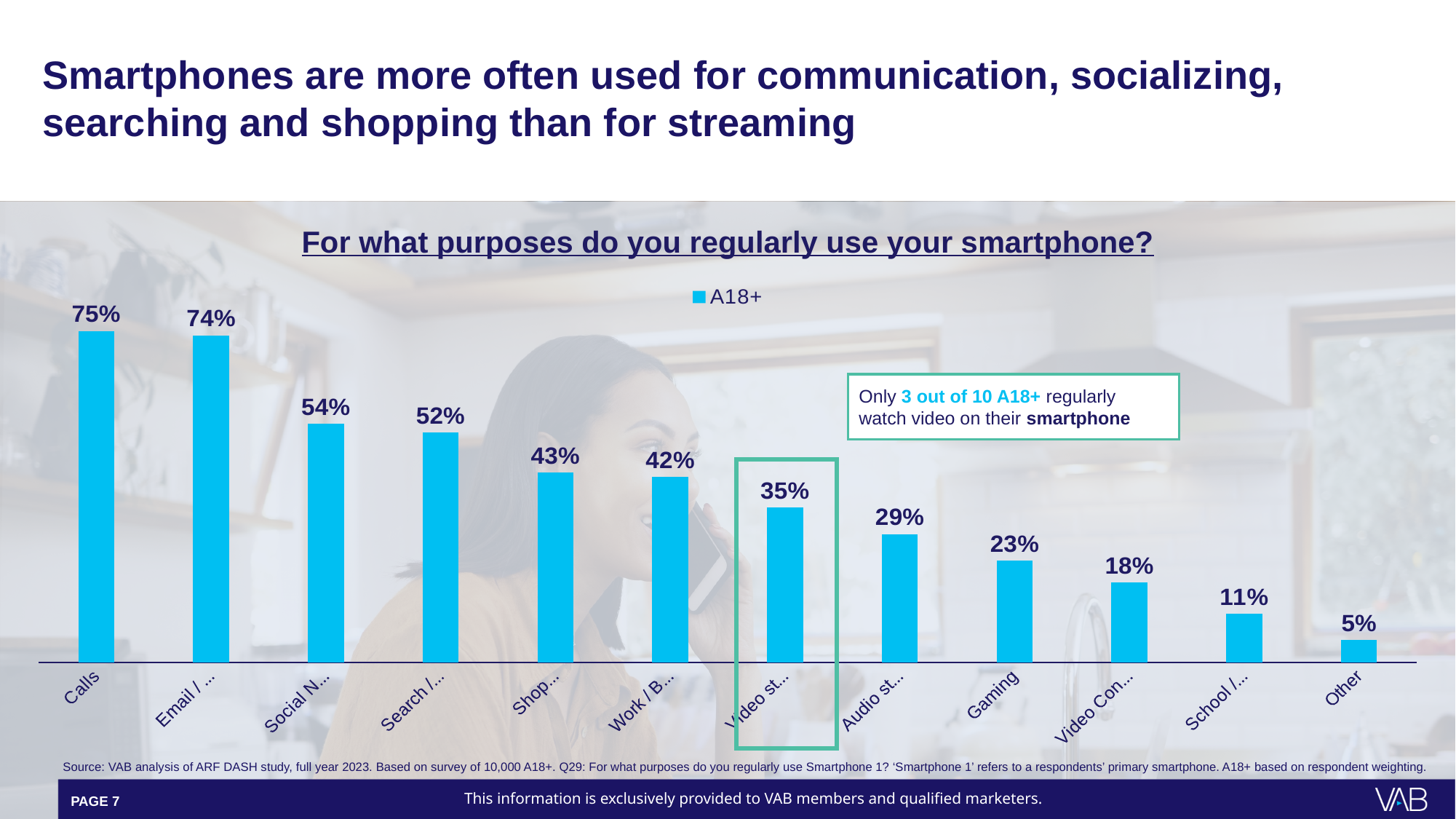
Which category has the lowest value? Other What is the difference between the values for Calls and Gaming? 52% What is the value for Other? 5% Which is larger, the value for Gaming or the value for Other? Gaming What is the value for Calls? 75% What is the value for the bar labelled 'Video st...'? 35% What type of chart is shown on the slide? bar chart What is the value for Gaming? 23% Which category has the highest value? Calls How many categories are shown in the chart? 12 What is the title of the chart? For what purposes do you regularly use your smartphone? How many series does the legend list? 1